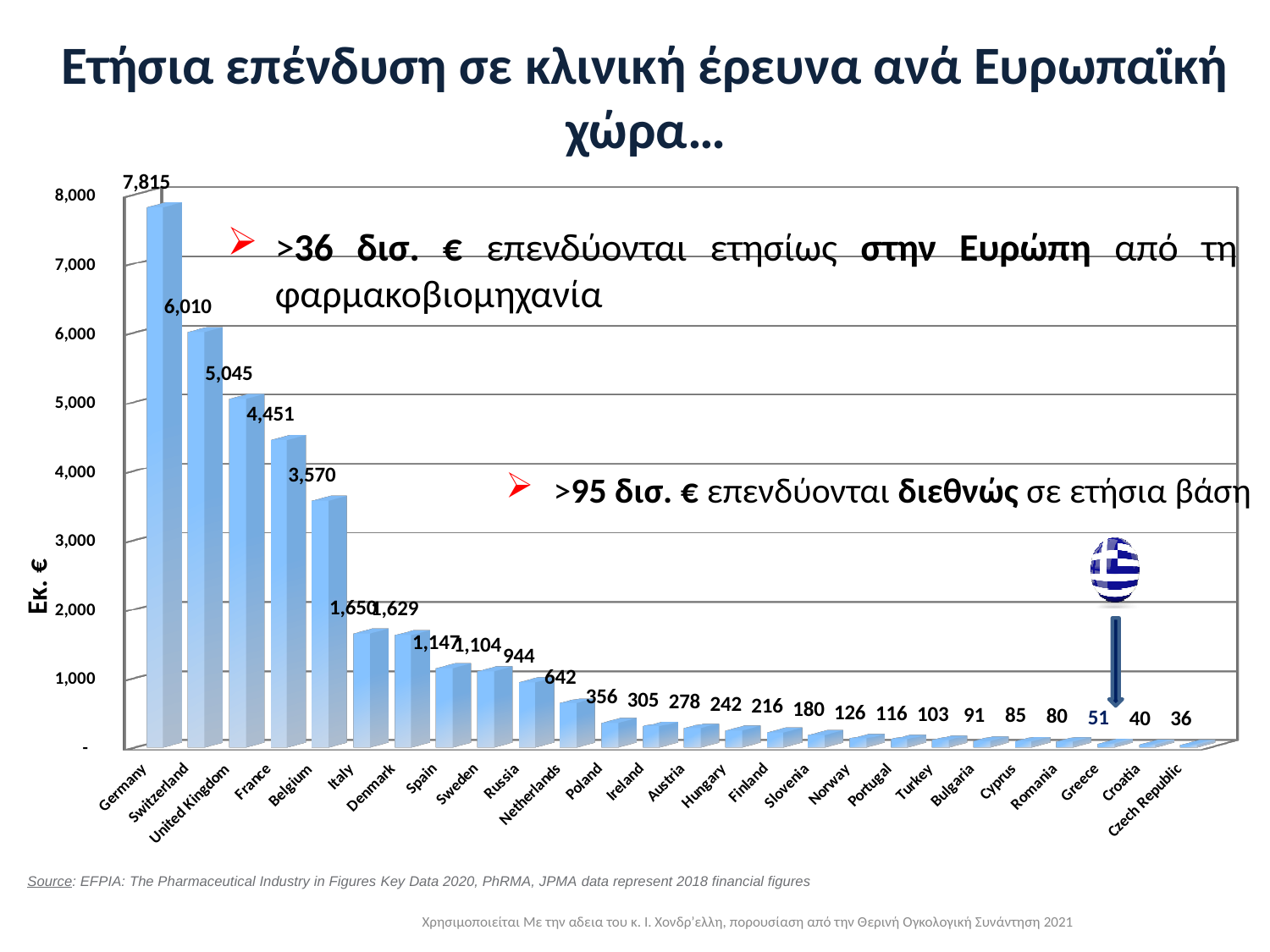
Do the values rise or fall from left to right along the x axis? Fall What is the value for Spain? 1,147 How many countries are shown on the chart? 26 What is the label on the vertical axis of the chart? Εκ. € What is the value for Netherlands? 642 What kind of chart is shown on the slide? Bar chart What is the value for Greece? 51 Which is larger, the value for France or the value for Belgium? France Which country has the highest value? Germany What is the difference between the values for Germany and Switzerland? 1,805 What is the value for Germany? 7,815 Which country has the lowest value? Czech Republic